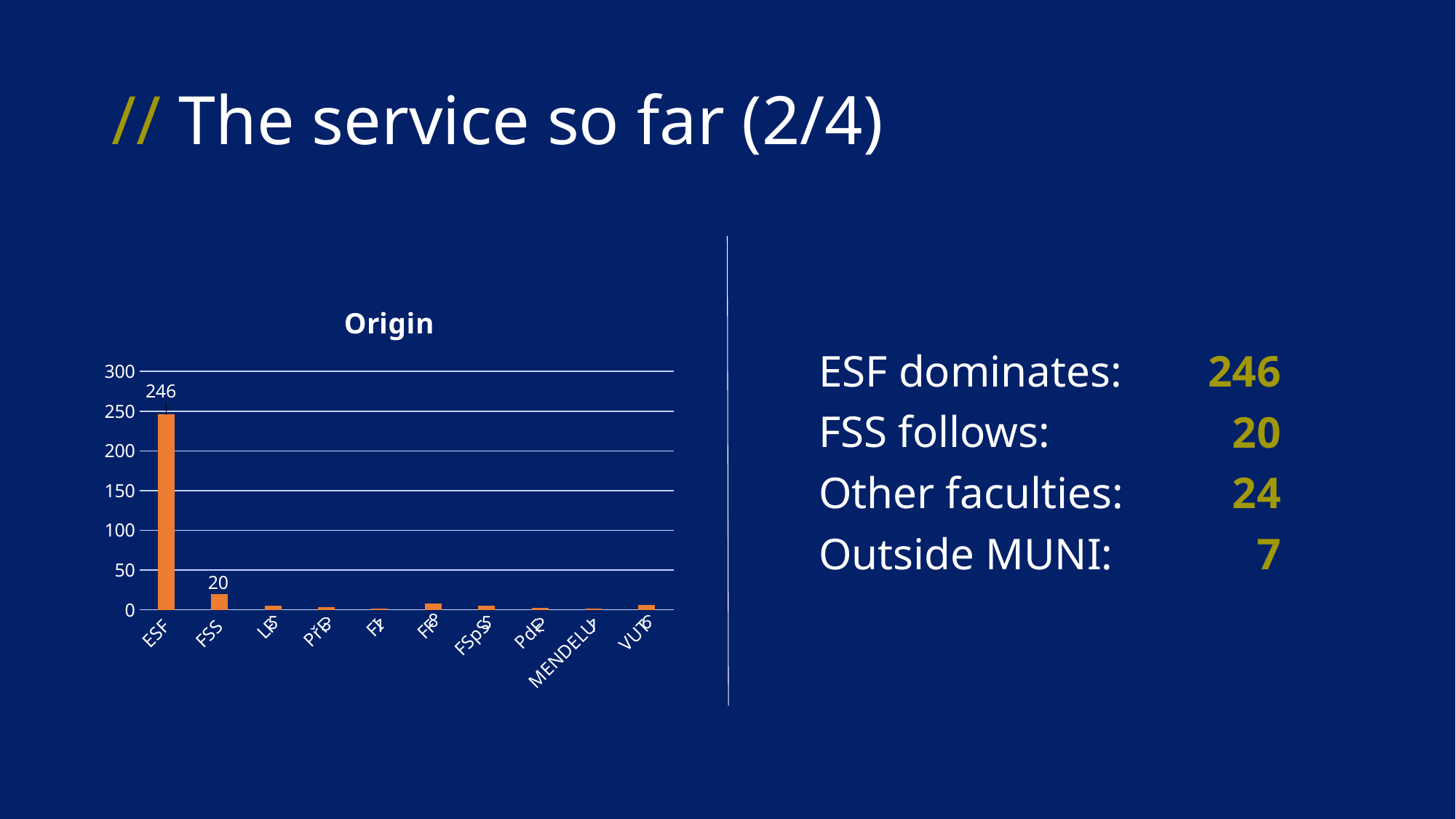
What is the value for ESF in the Origin chart? 246 What kind of chart is the Origin chart? bar chart What colour are the bars in the Origin chart? orange Is the value for ESF in the Origin chart greater or less than 200? greater What is the title of the chart on the slide? Origin Which category has the highest value in the Origin chart? ESF Which has a larger value in the Origin chart, ESF or FSS? ESF How many categories are shown on the x axis of the Origin chart? 10 What is the value for FSS in the Origin chart? 20 Is the value for FSS in the Origin chart greater or less than 50? less Is the value for FF in the Origin chart greater or less than 50? less What is the difference between the values for ESF and FSS in the Origin chart? 226